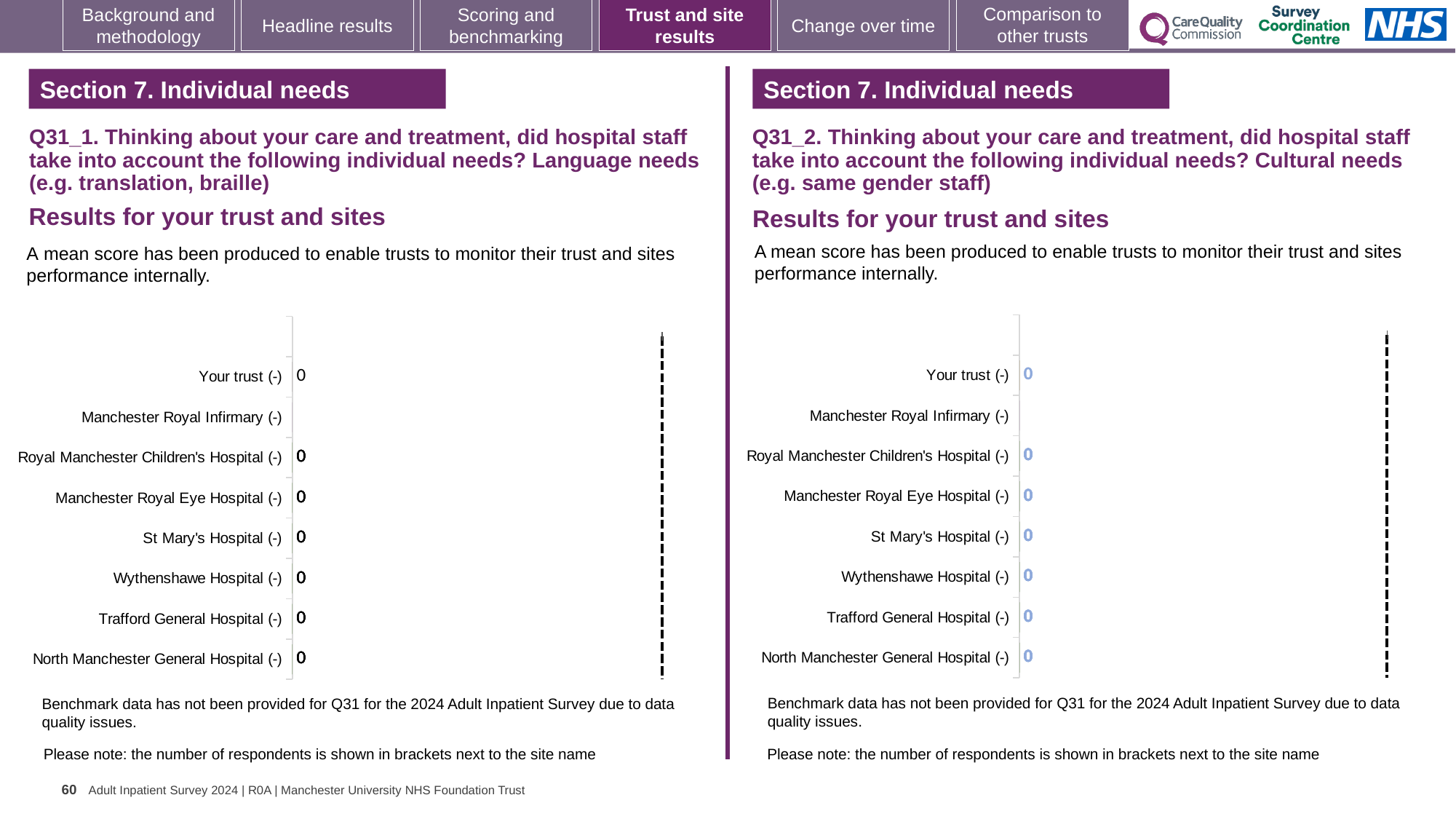
What number of respondents is shown in brackets next to each site name on the left chart (Q31_1, Language needs)? - On the left chart (Q31_1, Language needs), what is the value shown for Wythenshawe Hospital? 0 On the right chart (Q31_2, Cultural needs), what is the value shown for Trafford General Hospital? 0 On the right chart (Q31_2, Cultural needs), what is the value shown for Your trust? 0 On the right chart (Q31_2, Cultural needs), which category has no data label printed next to it? Manchester Royal Infirmary (-) On the left chart (Q31_1, Language needs), what is the value shown for North Manchester General Hospital? 0 On the right chart (Q31_2, Cultural needs), what is the value shown for St Mary's Hospital? 0 What kind of chart is the left chart (Q31_1, Language needs)? Bar chart How many categories (sites including Your trust) are listed on the right chart (Q31_2, Cultural needs)? 8 On the left chart (Q31_1, Language needs), what is the value shown for Your trust? 0 On the left chart (Q31_1, Language needs), what is the difference between the values for Your trust and Manchester Royal Eye Hospital? 0 How many categories (sites including Your trust) are listed on the left chart (Q31_1, Language needs)? 8